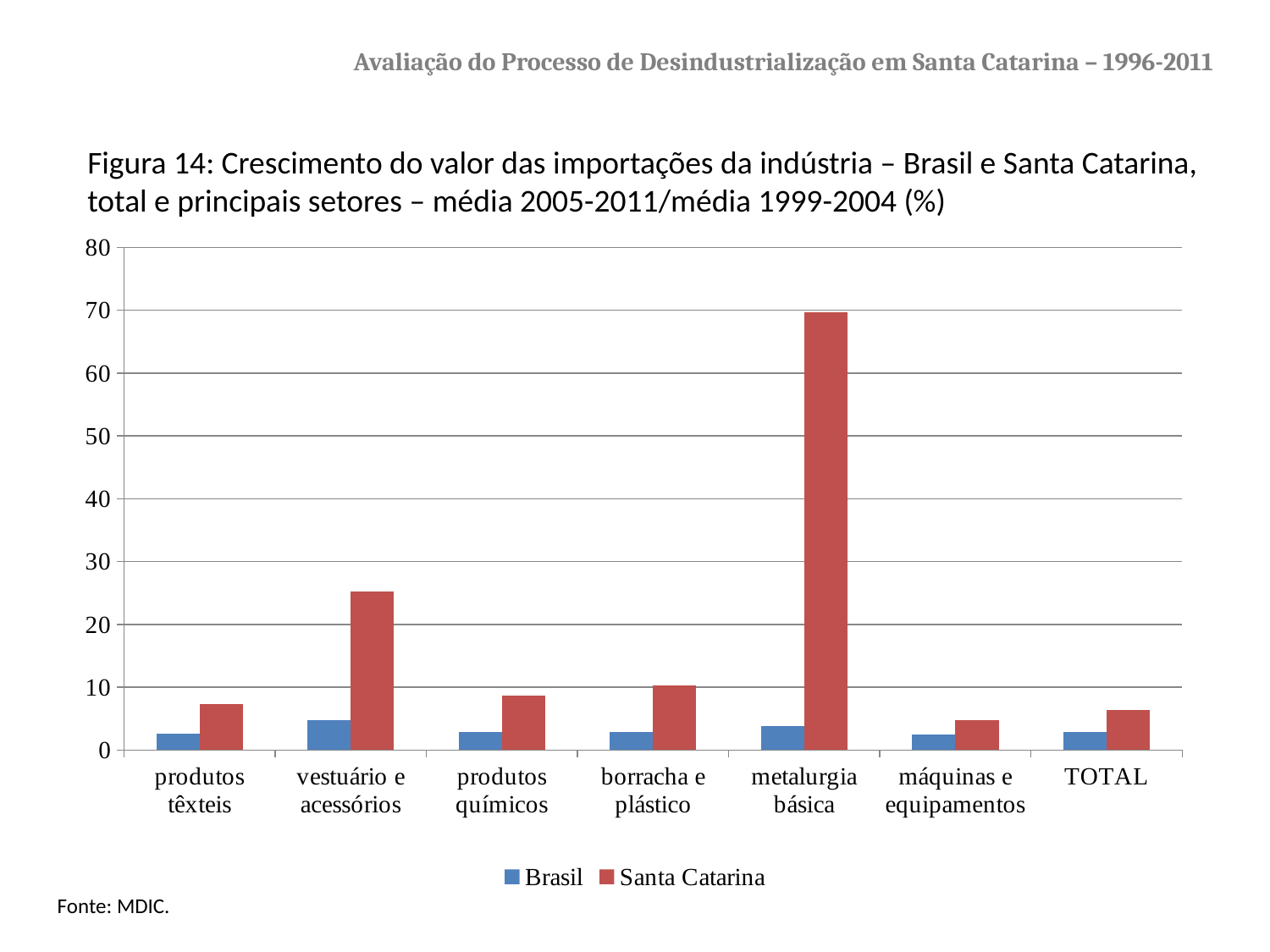
Is the value for Santa Catarina in vestuário e acessórios greater or less than 20? greater Is the value for Santa Catarina in metalurgia básica greater or less than 60? greater How many categories are shown on the x axis? 7 Which category has the lowest value for Santa Catarina? máquinas e equipamentos What kind of chart is shown on the slide? bar chart Which category has the highest value for Brasil? vestuário e acessórios In metalurgia básica, which is larger: the value for Brasil or for Santa Catarina? Santa Catarina What colour are the bars for Santa Catarina? red Is the value for Santa Catarina in produtos químicos greater or less than 10? less Which category has the highest value for Santa Catarina? metalurgia básica How many series does the legend list? 2